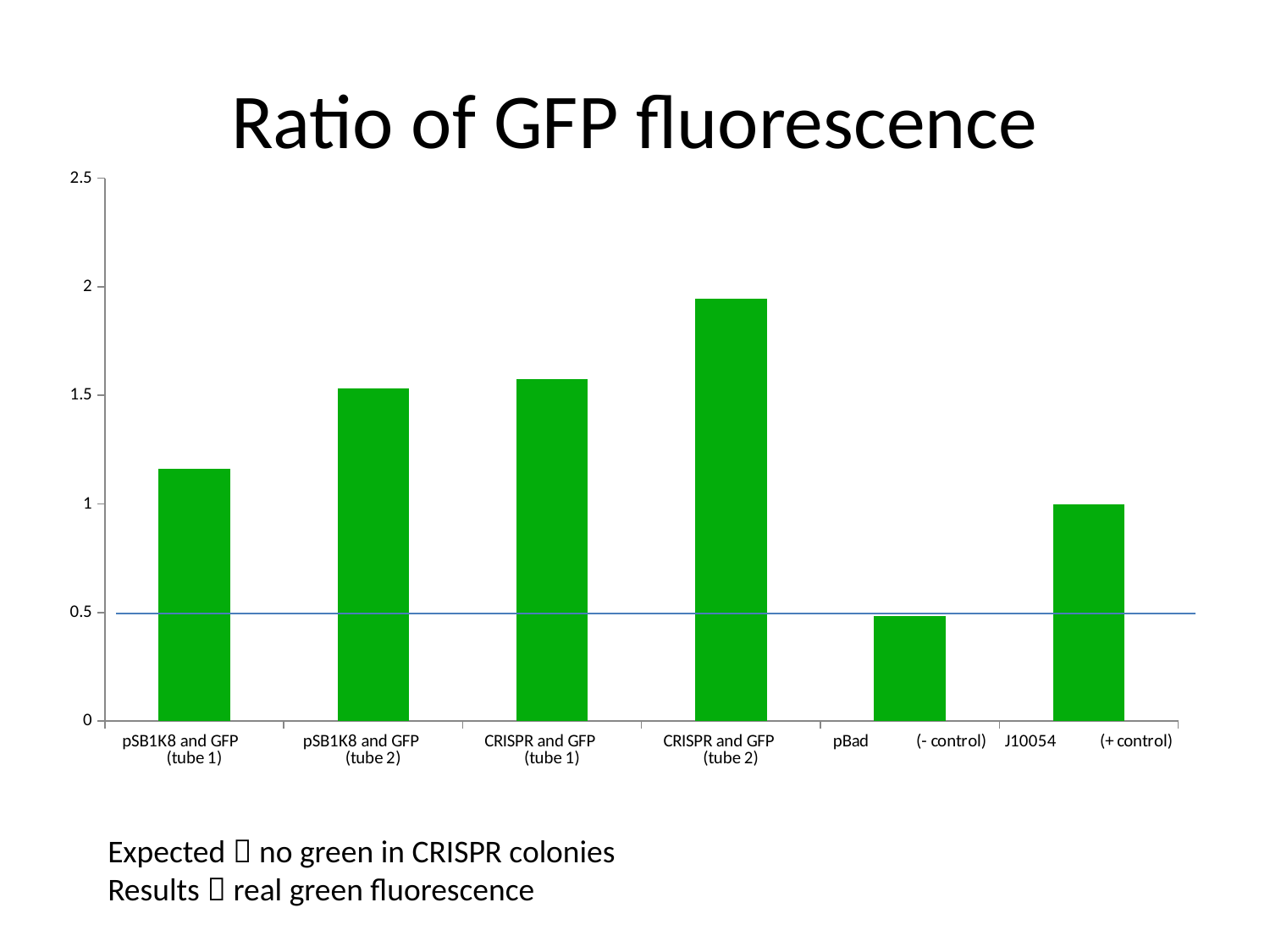
Which category has the lowest ratio of GFP fluorescence? pBad (- control) What is the title of the chart? Ratio of GFP fluorescence Is the value for pSB1K8 and GFP (tube 1) greater or less than 1? greater Which is larger, the value for CRISPR and GFP (tube 2) or the value for pSB1K8 and GFP (tube 1)? CRISPR and GFP (tube 2) What is the maximum value shown on the vertical axis? 2.5 How many bars are plotted in the chart? 6 Is the value for pBad (- control) greater or less than 1? less What kind of chart is shown on the slide? bar chart Which category has the highest ratio of GFP fluorescence? CRISPR and GFP (tube 2) Which is larger, the value for J10054 (+ control) or the value for pBad (- control)? J10054 (+ control) Is the value for CRISPR and GFP (tube 2) greater or less than 2? less